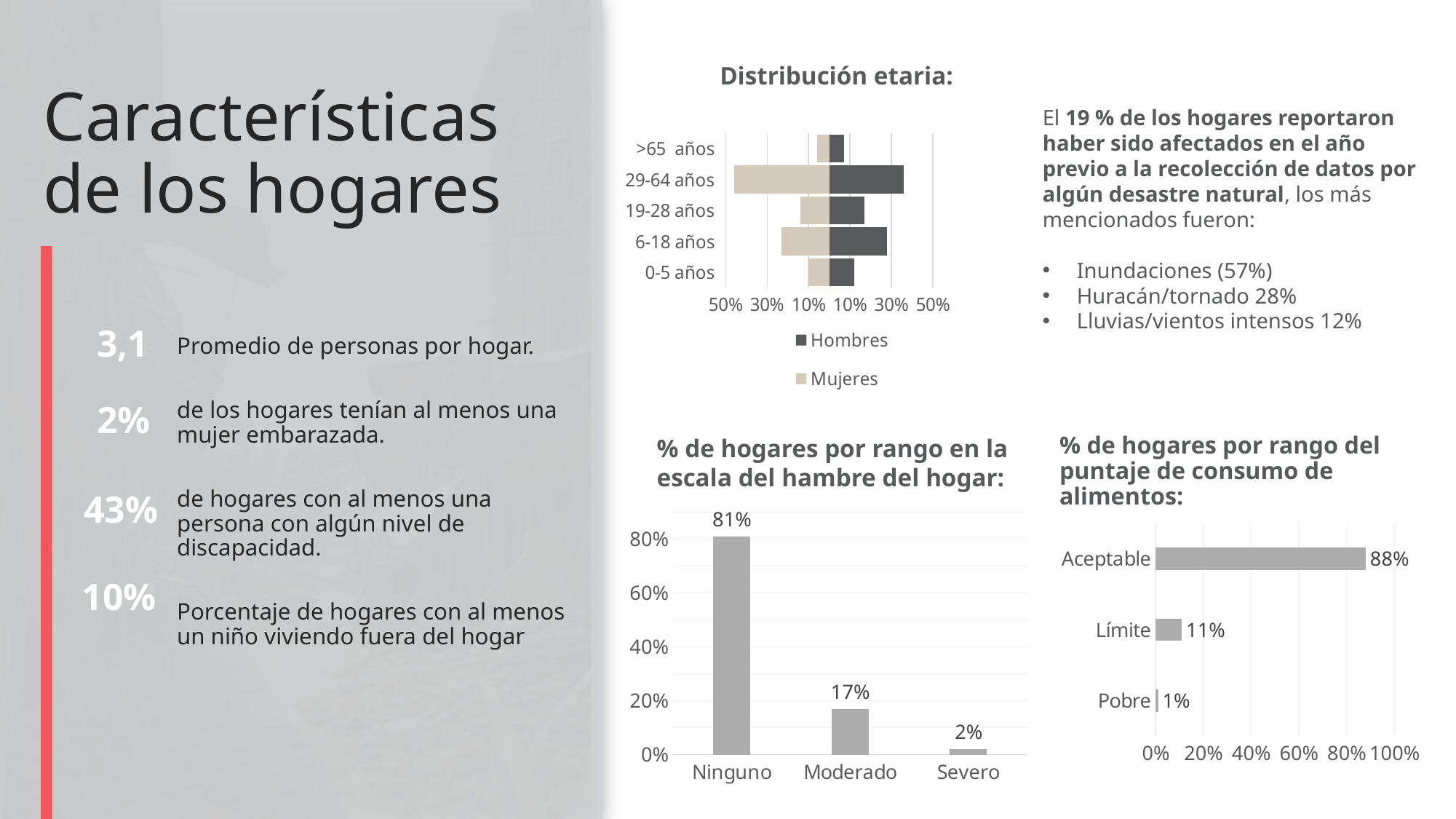
What kind of chart is 'Distribución etaria'? Bar chart In the chart '% de hogares por rango del puntaje de consumo de alimentos', what is the value for Aceptable? 88% In the chart 'Distribución etaria', how many series does the legend list? 2 In the chart '% de hogares por rango del puntaje de consumo de alimentos', how many categories are shown? 3 In the chart '% de hogares por rango del puntaje de consumo de alimentos', which category has the highest value? Aceptable In the chart '% de hogares por rango en la escala del hambre del hogar', which category has the lowest value? Severo In the chart '% de hogares por rango en la escala del hambre del hogar', what is the value for Moderado? 17% In the chart '% de hogares por rango en la escala del hambre del hogar', what is the value for Ninguno? 81% In the chart 'Distribución etaria', is the Hombres value for 29-64 años greater or less than 10%? greater In the chart '% de hogares por rango del puntaje de consumo de alimentos', what is the difference between Límite and Pobre? 10% In the chart '% de hogares por rango del puntaje de consumo de alimentos', what is the value for Pobre? 1% In the chart '% de hogares por rango en la escala del hambre del hogar', what is the difference between Ninguno and Moderado? 64%